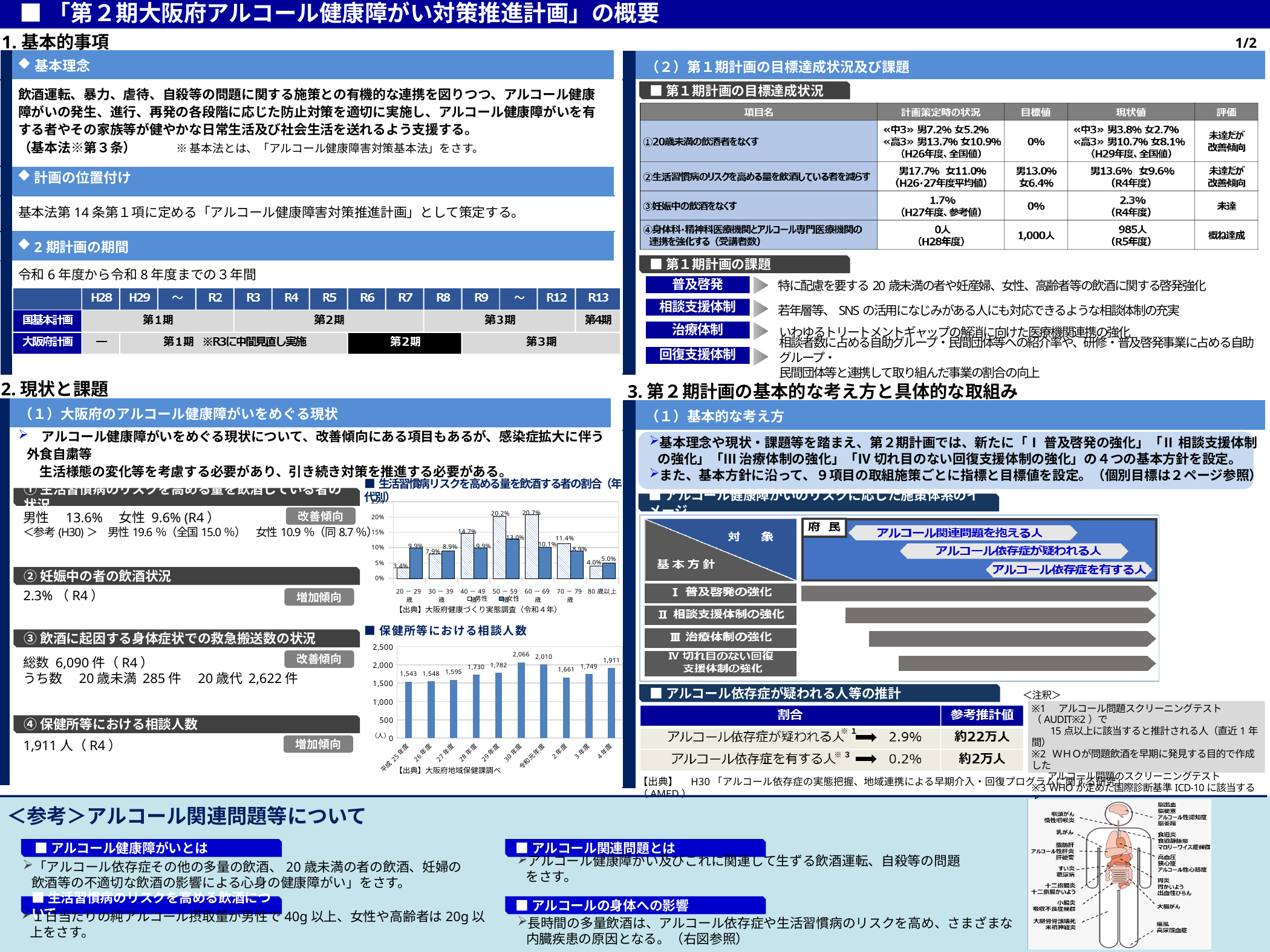
In the chart titled 「保健所等における相談人数」, which year has the highest value? 30年度 In the chart titled 「生活習慣病リスクを高める量を飲酒する者の割合（年代別）」, what is the difference between the 男性 and 女性 values for the 40－49歳 group? 4.8% In the chart titled 「保健所等における相談人数」, what is the difference between the values for 30年度 and 令和元年度? 56 In the chart titled 「生活習慣病リスクを高める量を飲酒する者の割合（年代別）」, what is the value for 男性 in the 60－69歳 group? 20.7% In the chart titled 「生活習慣病リスクを高める量を飲酒する者の割合（年代別）」, how many series does the legend list? 2 In the chart titled 「保健所等における相談人数」, is the value for 2年度 larger or smaller than the value for 3年度? smaller What kind of chart is 「保健所等における相談人数」? bar chart In the chart titled 「保健所等における相談人数」, what is the value for 令和4年度? 1,911 In the chart titled 「生活習慣病リスクを高める量を飲酒する者の割合（年代別）」, what is the value for 女性 in the 50－59歳 group? 13.0% In the chart titled 「保健所等における相談人数」, how many years are plotted? 10 In the chart titled 「生活習慣病リスクを高める量を飲酒する者の割合（年代別）」, how many age groups are shown on the x axis? 7 In the chart titled 「保健所等における相談人数」, which year has the lowest value? 平成25年度